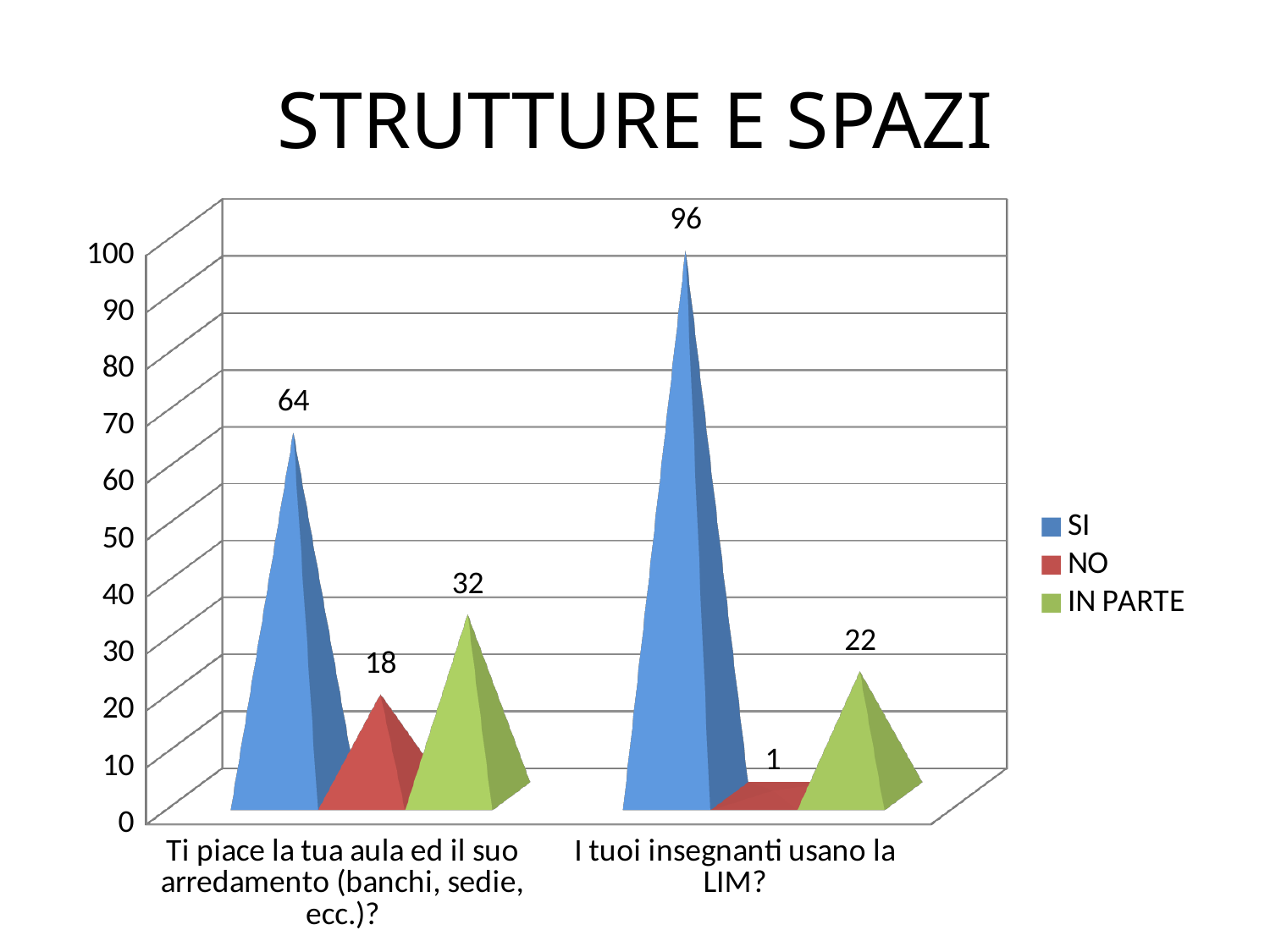
How many series does the legend list? 3 What is the difference between the IN PARTE values for the two questions? 10 Which series has the highest value for the question "I tuoi insegnanti usano la LIM?"? SI What is the value for IN PARTE for the question "Ti piace la tua aula ed il suo arredamento (banchi, sedie, ecc.)?"? 32 Which is larger: the NO value for "Ti piace la tua aula ed il suo arredamento (banchi, sedie, ecc.)?" or the IN PARTE value for "I tuoi insegnanti usano la LIM?"? IN PARTE for "I tuoi insegnanti usano la LIM?" What is the difference between the SI values for the two questions? 32 What colour represents the NO series? Red What is the value for NO for the question "I tuoi insegnanti usano la LIM?"? 1 Which series has the lowest value for the question "Ti piace la tua aula ed il suo arredamento (banchi, sedie, ecc.)?"? NO How many question categories are shown on the x axis? 2 What is the value for SI for the question "Ti piace la tua aula ed il suo arredamento (banchi, sedie, ecc.)?"? 64 What is the title of the slide? STRUTTURE E SPAZI